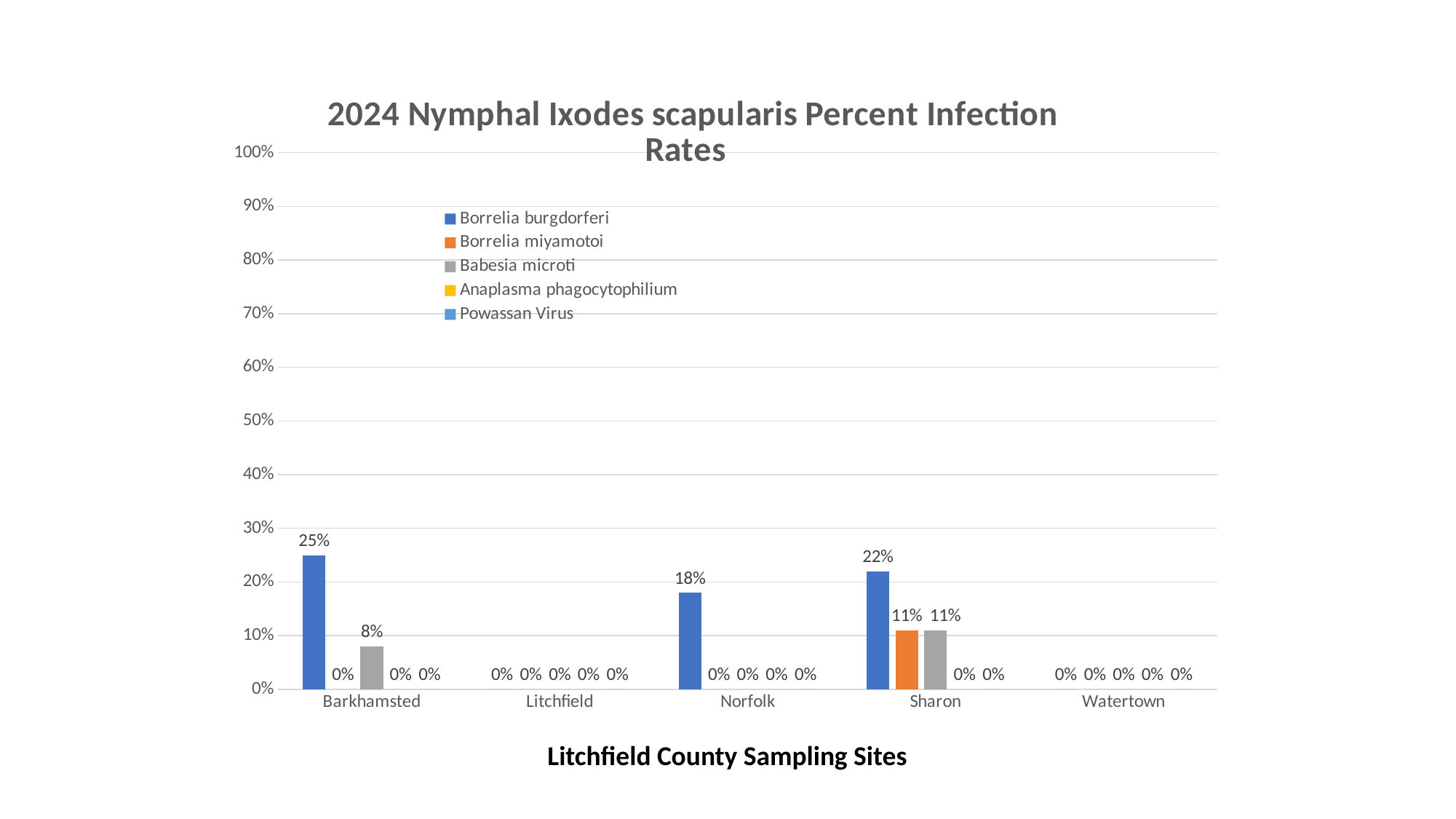
How many series does the legend list? 5 What is the Anaplasma phagocytophilium infection rate at Watertown? 0% What is the difference between the Borrelia burgdorferi rates at Barkhamsted and Sharon? 3% How many sampling sites are shown on the x axis? 5 What is the Babesia microti infection rate at Sharon? 11% What is the Borrelia burgdorferi infection rate at Barkhamsted? 25% Which is larger, the Babesia microti rate at Barkhamsted or at Sharon? Sharon What kind of chart is shown on the slide? Bar chart Which sampling site has the highest Borrelia burgdorferi infection rate? Barkhamsted What is the x-axis title of the chart? Litchfield County Sampling Sites What is the Borrelia miyamotoi infection rate at Sharon? 11% What is the Borrelia burgdorferi infection rate at Norfolk? 18%